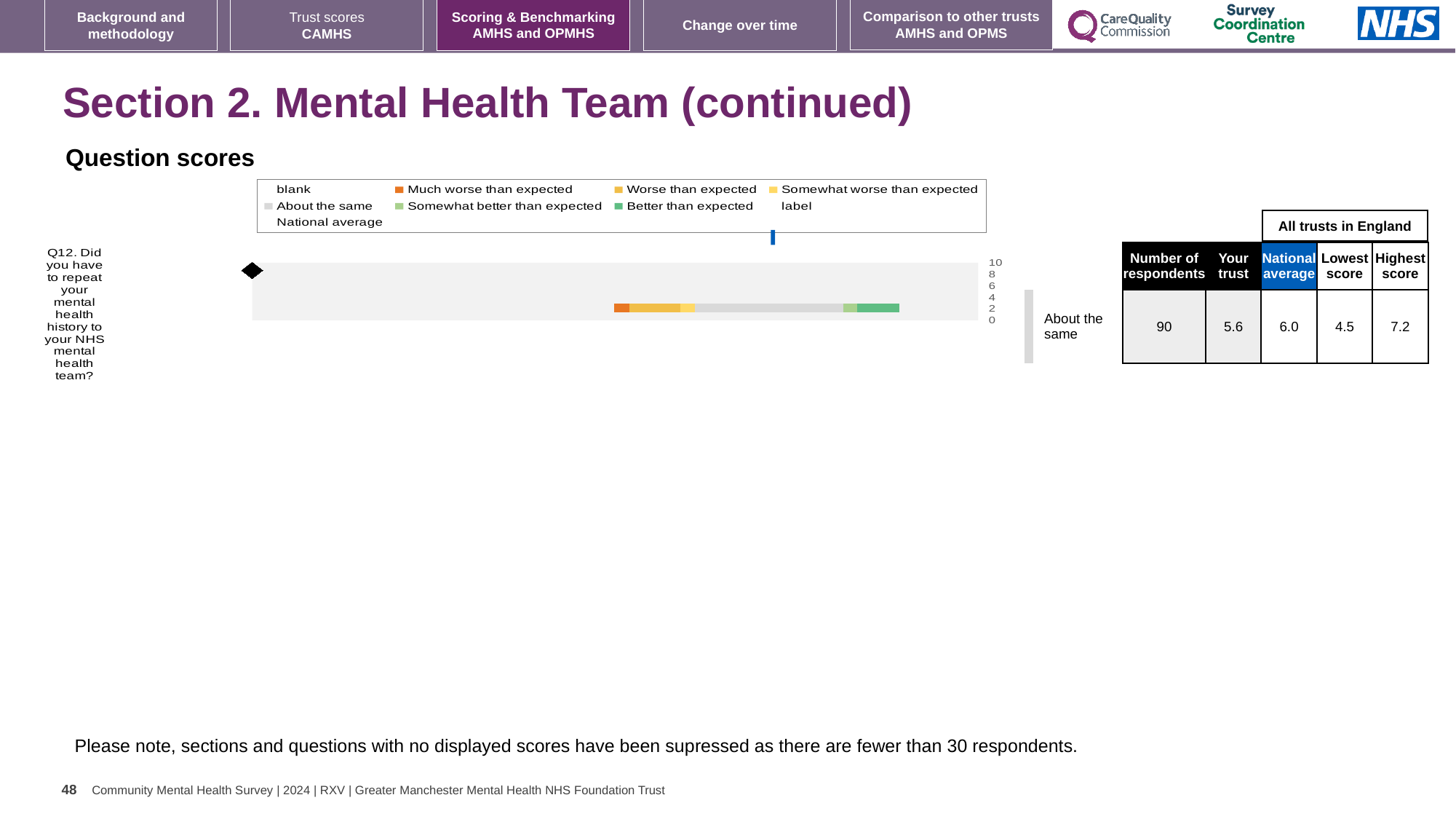
What is the difference between the national average and the 'Your trust' score for Q12? 0.4 Which is larger for Q12, the 'Your trust' score or the national average? National average How many respondents answered Q12? 90 What is the 'Your trust' score for Q12 (Did you have to repeat your mental health history to your NHS mental health team?)? 5.6 Which benchmark category is shown next to the Q12 bar? About the same What kind of chart is used to show the Q12 question score? bar chart What is the highest score among all trusts in England for Q12? 7.2 What is the difference between the highest score and the lowest score for Q12? 2.7 What colour represents 'Much worse than expected' in the legend? Orange What is the lowest score among all trusts in England for Q12? 4.5 What is the national average score for Q12? 6.0 How many questions are plotted on the chart? 1